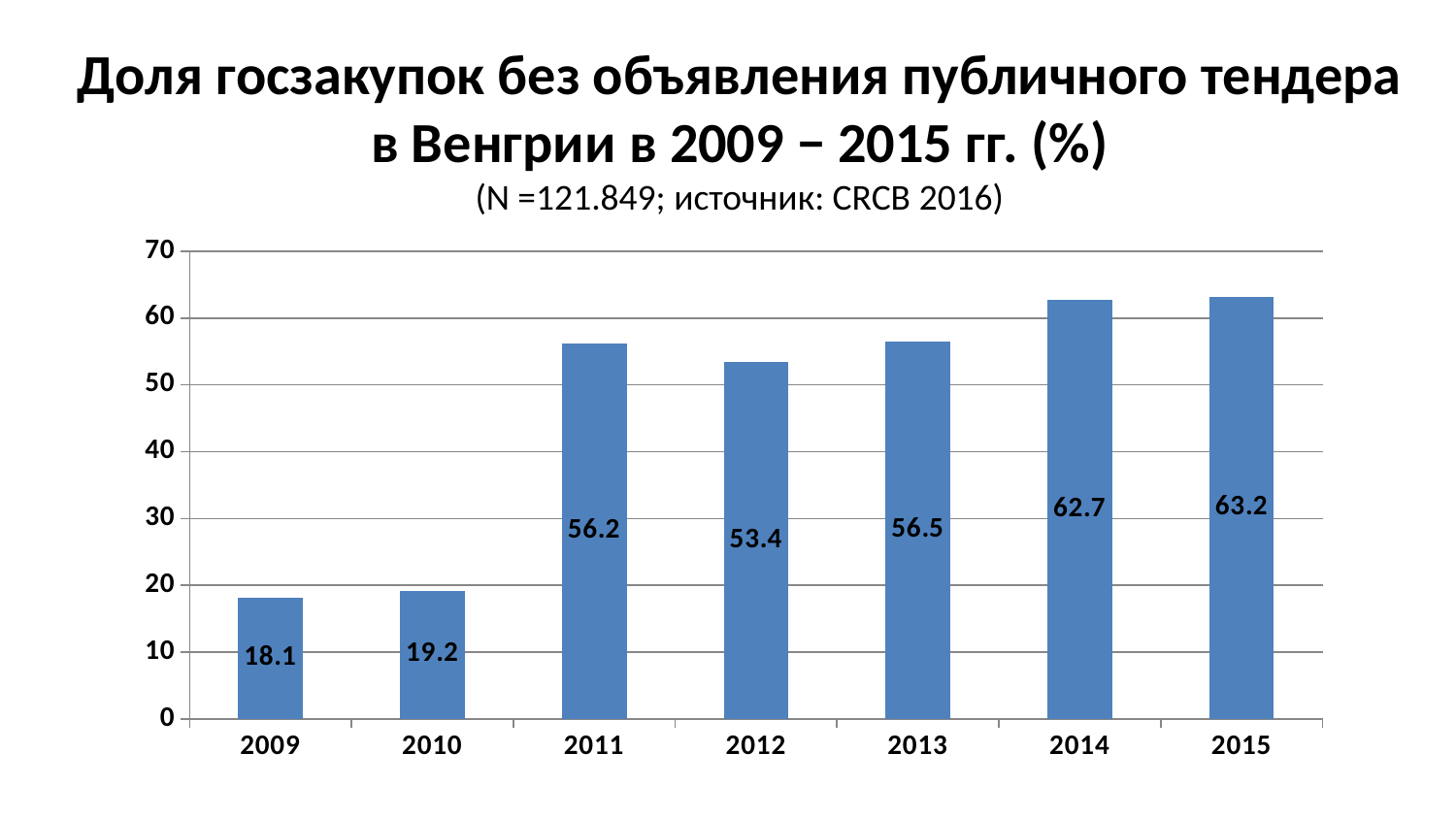
What is the value for 2012? 53.4 What is the value for 2009? 18.1 Which is larger, the value for 2011 or the value for 2012? 2011 What kind of chart is shown on the slide? bar chart Which year has the lowest value? 2009 What is the difference between the values for 2015 and 2009? 45.1 How many years are shown on the x axis? 7 What is the value for 2014? 62.7 What is the sample size (N) given in the chart subtitle? 121.849 Which year has the highest value? 2015 Is the value for 2013 greater or less than 50? greater What is the difference between the values for 2011 and 2012? 2.8